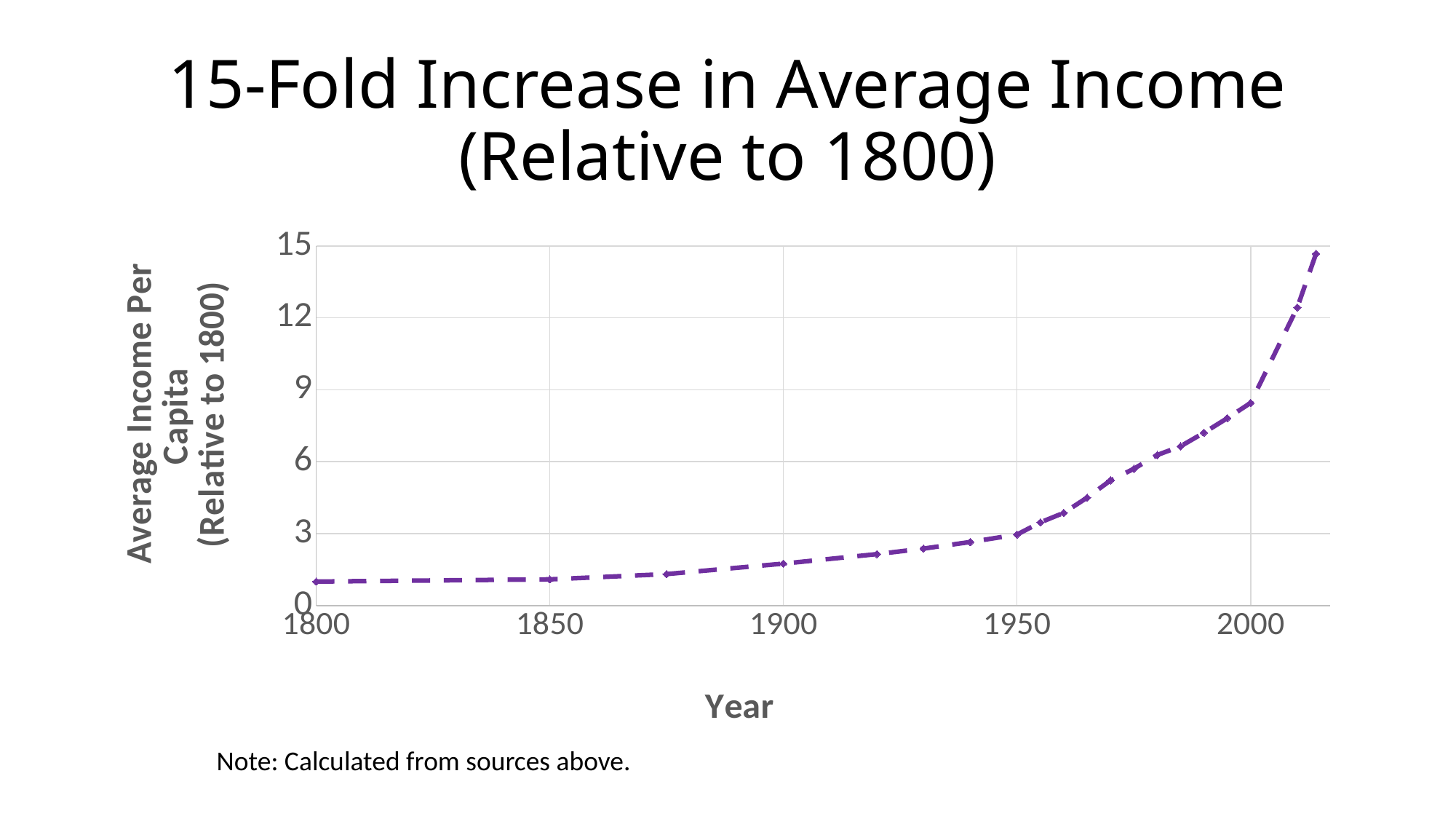
Which is larger, the value for 1900 or the value for 2000? 2000 What kind of chart is shown on the slide? line chart Which is larger, the value for 1850 or the value for 1950? 1950 Is the value for 1900 greater or less than 3? less Is the highest value on the line at the start or the end of the series? end Do the values rise or fall as the year increases along the x axis? rise Is the value for 1950 greater or less than 6? less Is the value for 1850 greater or less than 3? less What is the title of the chart? 15-Fold Increase in Average Income (Relative to 1800) What is the label of the x axis? Year